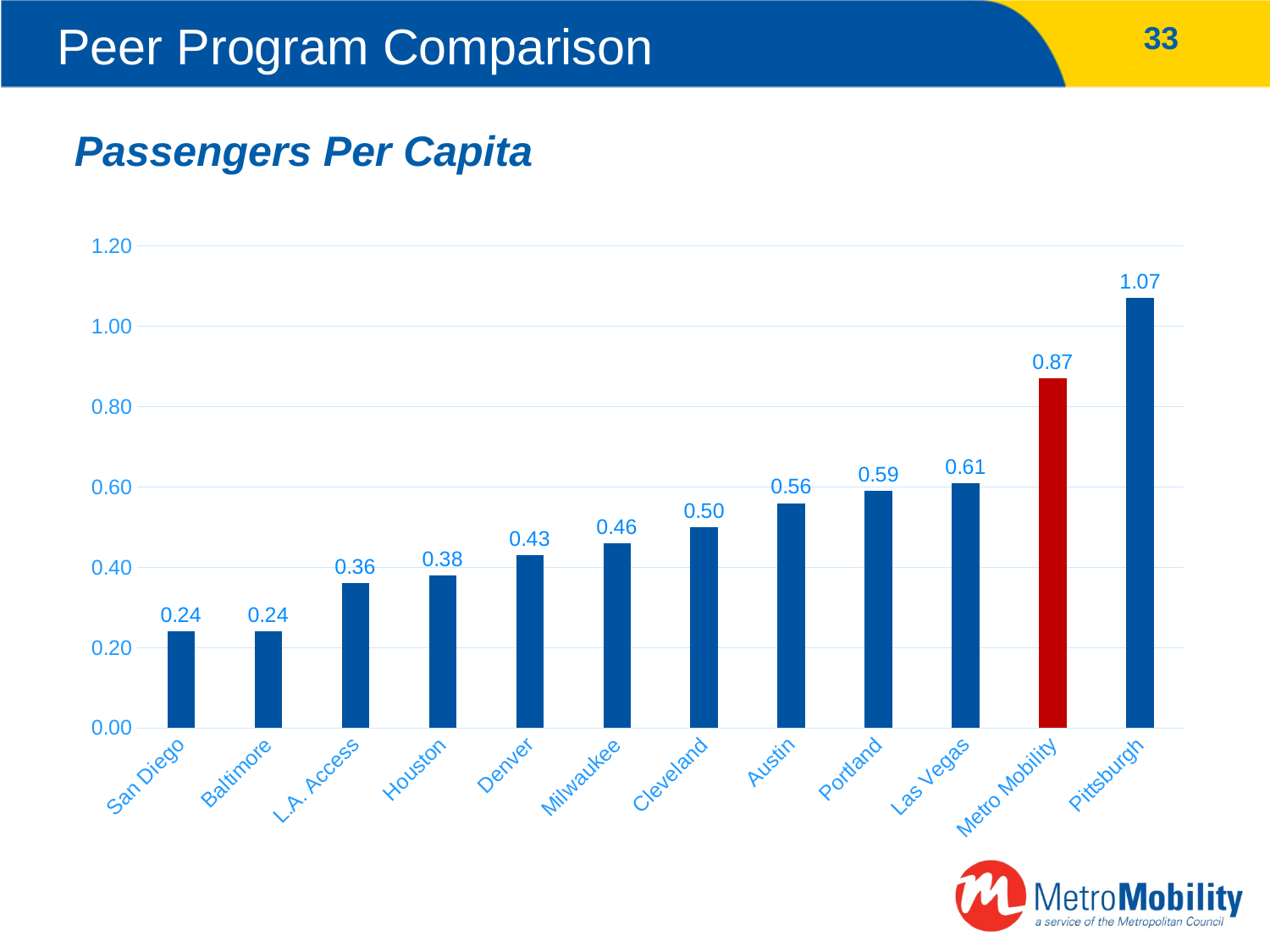
Is the value for Portland greater or less than 0.40? greater What is the difference in passengers per capita between Pittsburgh and Metro Mobility? 0.20 How many cities or programs are shown in the chart? 12 What is the passengers per capita value for Metro Mobility? 0.87 What is the passengers per capita value for Las Vegas? 0.61 What is the difference in passengers per capita between Austin and Houston? 0.18 Which has a higher passengers per capita value, Cleveland or Milwaukee? Cleveland What is the passengers per capita value for Denver? 0.43 What kind of chart is shown on the slide? Bar chart Do the values rise or fall from left to right across the chart? Rise Which bar is coloured red instead of blue? Metro Mobility Which city has the highest passengers per capita? Pittsburgh